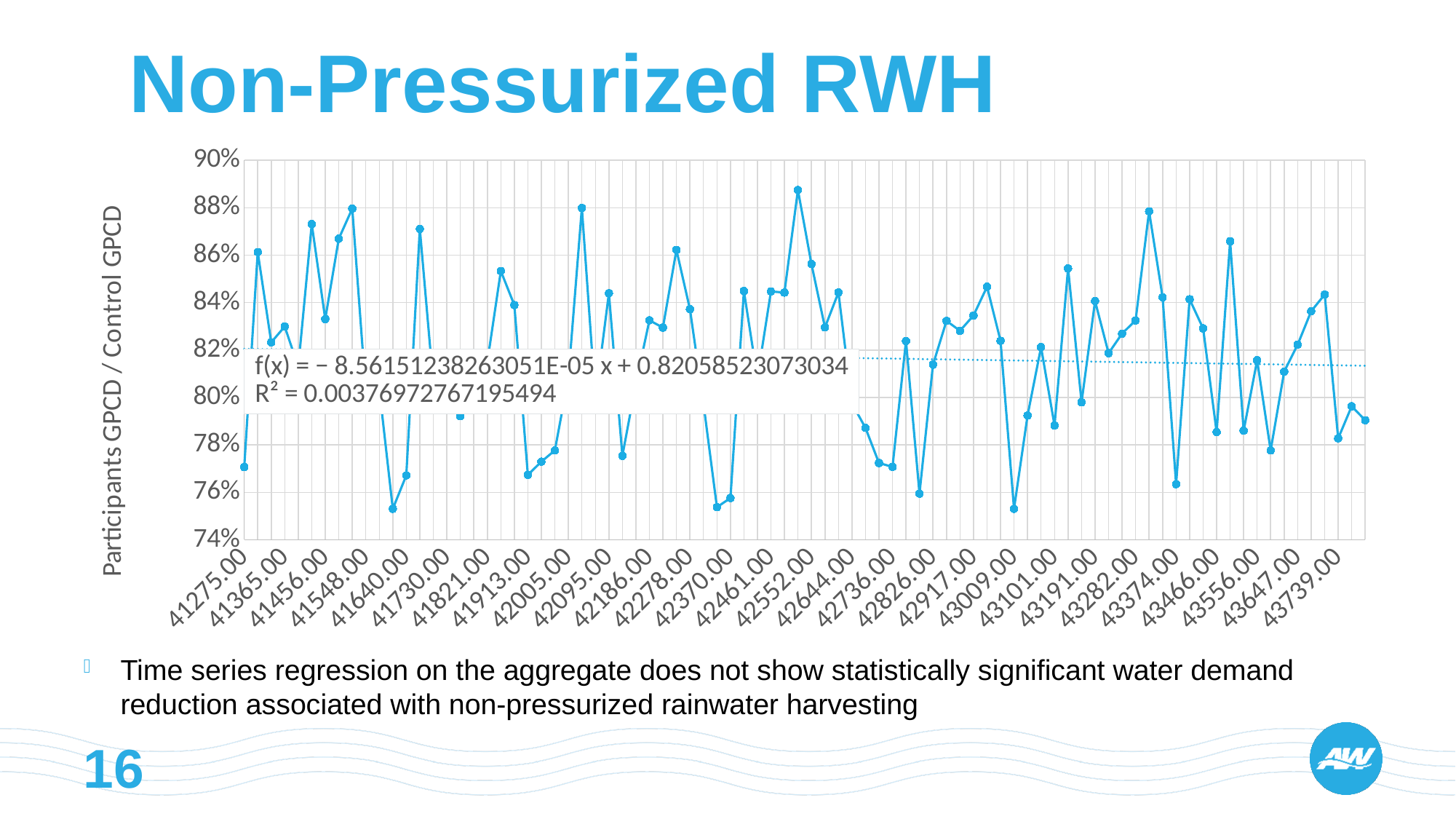
What R² value is printed on the chart for the trendline? R² = 0.00376972767195494 Is the value at the first x-axis label, 41275.00, greater or less than 80%? less Is the highest point on the chart greater or less than 88%? greater What kind of chart is shown on the slide? line chart What is the highest value shown on the vertical axis of the chart? 90% Is the value at the last x-axis label, 43739.00, greater or less than 80%? less What is the title of the vertical axis of the chart? Participants GPCD / Control GPCD What is the trendline equation printed on the chart? f(x) = − 8.56151238263051E-05 x + 0.82058523073034 What is the lowest value shown on the vertical axis of the chart? 74% According to the dotted trendline, do the values rise or fall along the x axis? fall slightly Is the slope of the fitted trendline positive or negative? negative